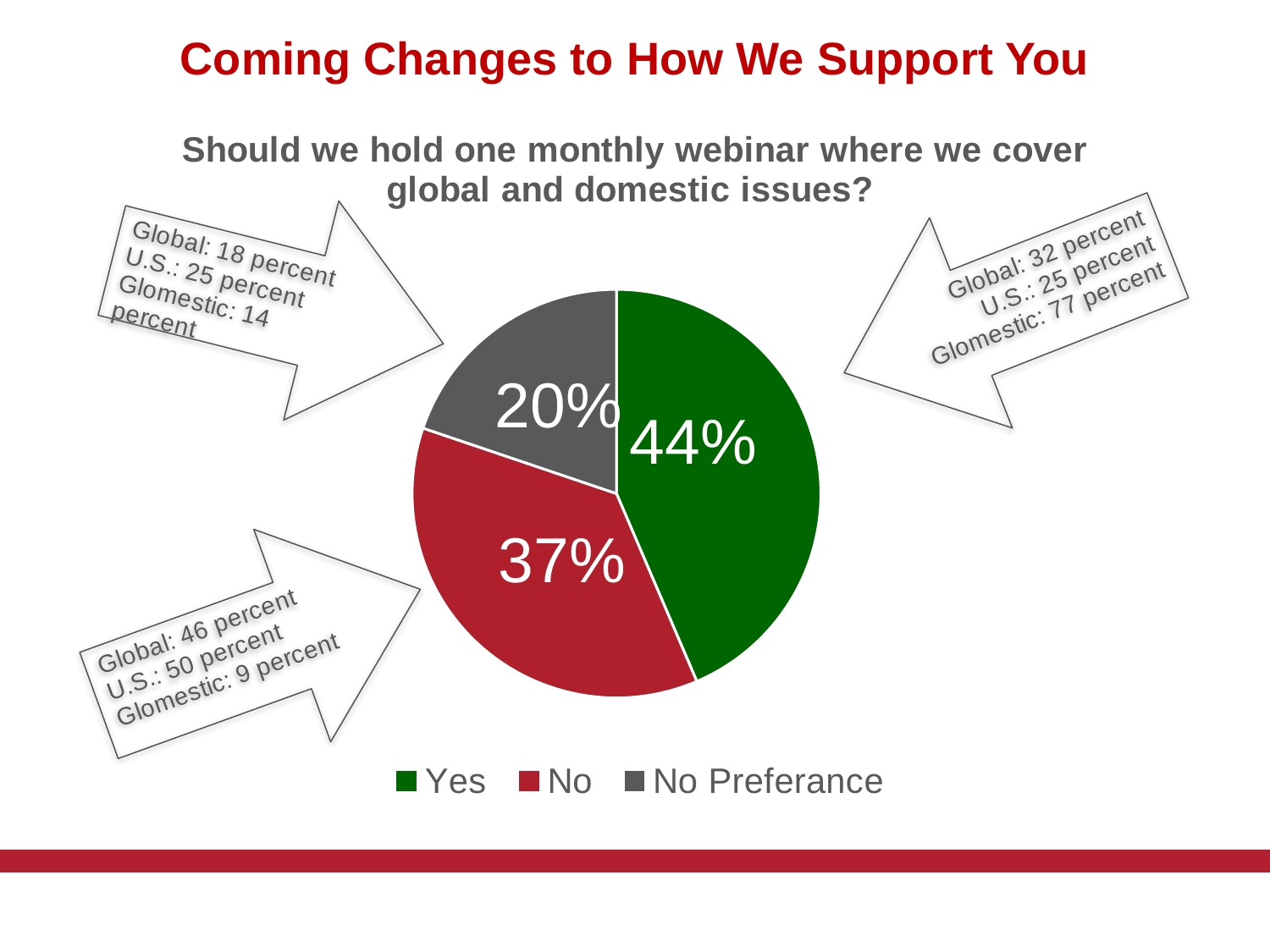
Which is larger, the "No" slice or the "No Preferance" slice? No What question does the pie chart present responses to? Should we hold one monthly webinar where we cover global and domestic issues? What share of the pie is labelled "Yes"? 44% Which slice of the pie is the largest? Yes What share of the pie is labelled "No"? 37% How many slices does the pie chart have? 3 What is the difference in percentage points between the "Yes" slice and the "No" slice? 7 What colour is the "Yes" slice of the pie? green How many entries does the legend list? 3 Which slice of the pie is the smallest? No Preferance What share of the pie is labelled "No Preferance"? 20% What kind of chart is shown on the slide? pie chart